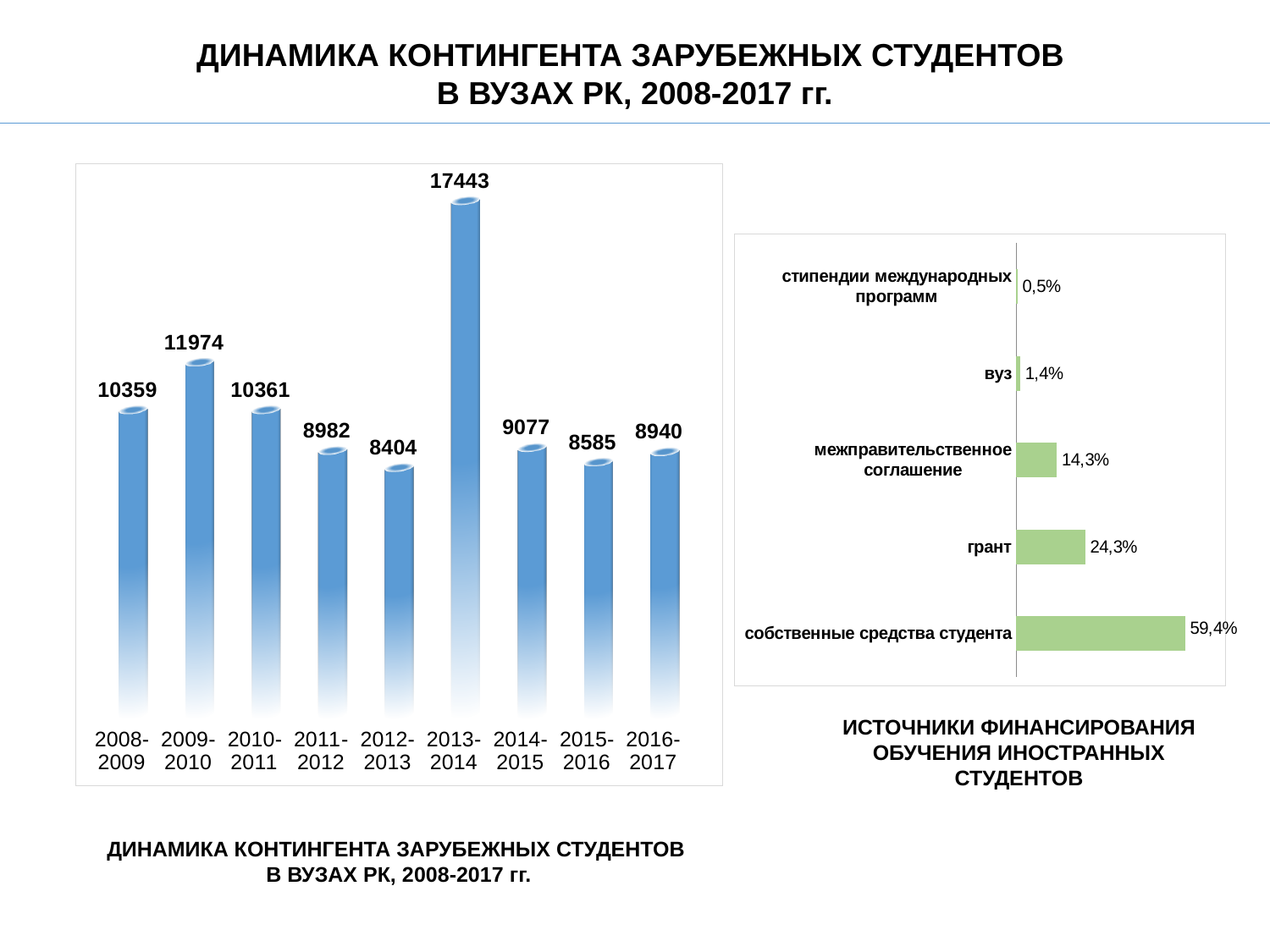
In the right chart (ИСТОЧНИКИ ФИНАНСИРОВАНИЯ), how many categories are shown? 5 In the left chart (ДИНАМИКА КОНТИНГЕНТА ЗАРУБЕЖНЫХ СТУДЕНТОВ), what is the value for 2008-2009? 10359 In the right chart (ИСТОЧНИКИ ФИНАНСИРОВАНИЯ), which category has the lowest value? стипендии международных программ In the left chart (ДИНАМИКА КОНТИНГЕНТА ЗАРУБЕЖНЫХ СТУДЕНТОВ), which academic year has the lowest value? 2012-2013 What kind of chart is the left chart (ДИНАМИКА КОНТИНГЕНТА ЗАРУБЕЖНЫХ СТУДЕНТОВ)? Bar chart In the left chart (ДИНАМИКА КОНТИНГЕНТА ЗАРУБЕЖНЫХ СТУДЕНТОВ), what is the value for 2013-2014? 17443 In the left chart (ДИНАМИКА КОНТИНГЕНТА ЗАРУБЕЖНЫХ СТУДЕНТОВ), how many academic years are shown? 9 In the right chart (ИСТОЧНИКИ ФИНАНСИРОВАНИЯ), which category has the highest value? собственные средства студента In the left chart (ДИНАМИКА КОНТИНГЕНТА ЗАРУБЕЖНЫХ СТУДЕНТОВ), what is the difference between the values for 2013-2014 and 2012-2013? 9039 In the right chart (ИСТОЧНИКИ ФИНАНСИРОВАНИЯ), what is the value for грант? 24,3% In the left chart (ДИНАМИКА КОНТИНГЕНТА ЗАРУБЕЖНЫХ СТУДЕНТОВ), which is larger: the value for 2009-2010 or 2010-2011? 2009-2010 In the left chart (ДИНАМИКА КОНТИНГЕНТА ЗАРУБЕЖНЫХ СТУДЕНТОВ), which academic year has the highest value? 2013-2014